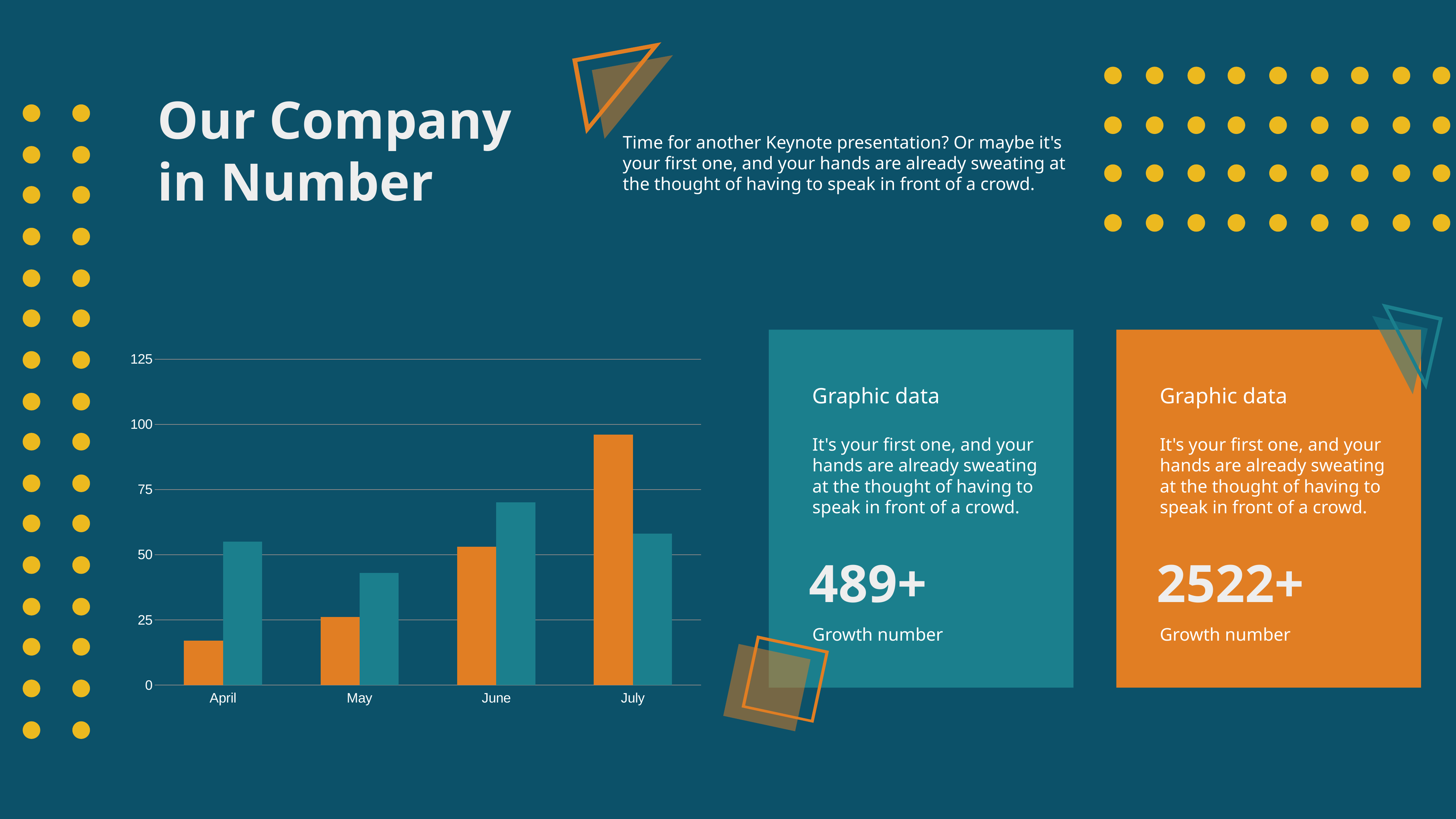
Do the orange bars rise or fall from April to July? rise In July, which bar is taller, the orange one or the teal one? orange In which month is the orange bar the shortest? April Is the value of the orange bar for April greater or less than 25? less How many months are shown on the x axis of the bar chart? 4 In which month is the orange bar the tallest? July Is the value of the teal bar for May greater or less than 50? less In April, which bar is taller, the orange one or the teal one? teal In which month is the teal bar the tallest? June What kind of chart is shown on the slide? bar chart In which month is the teal bar the shortest? May Is the value of the orange bar for July greater or less than 75? greater